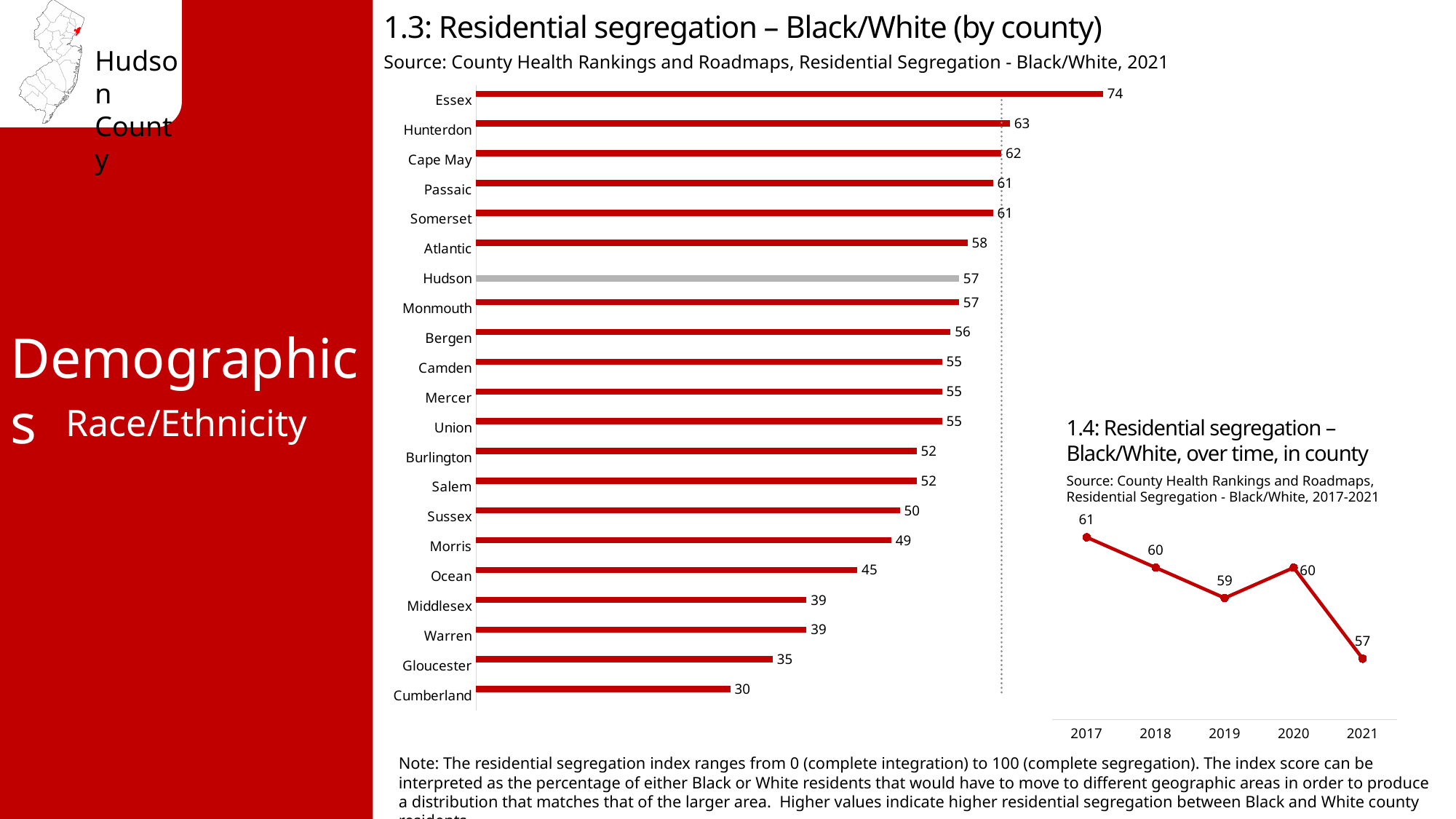
In the chart '1.3: Residential segregation – Black/White (by county)', which county has the lowest value? Cumberland In the chart '1.4: Residential segregation – Black/White, over time, in county', what is the value for 2019? 59 In the chart '1.3: Residential segregation – Black/White (by county)', which county has the highest value? Essex In the chart '1.4: Residential segregation – Black/White, over time, in county', which year has the lowest value? 2021 In the chart '1.3: Residential segregation – Black/White (by county)', what is the difference between the values for Essex and Cumberland? 44 What kind of chart is '1.4: Residential segregation – Black/White, over time, in county'? Line chart In the chart '1.3: Residential segregation – Black/White (by county)', what is the value for Hudson? 57 What kind of chart is '1.3: Residential segregation – Black/White (by county)'? Bar chart In the chart '1.3: Residential segregation – Black/White (by county)', how many counties are shown? 21 In the chart '1.3: Residential segregation – Black/White (by county)', which is larger, the value for Ocean or the value for Middlesex? Ocean In the chart '1.3: Residential segregation – Black/White (by county)', what is the value for Gloucester? 35 In the chart '1.4: Residential segregation – Black/White, over time, in county', what is the difference between the values for 2017 and 2021? 4